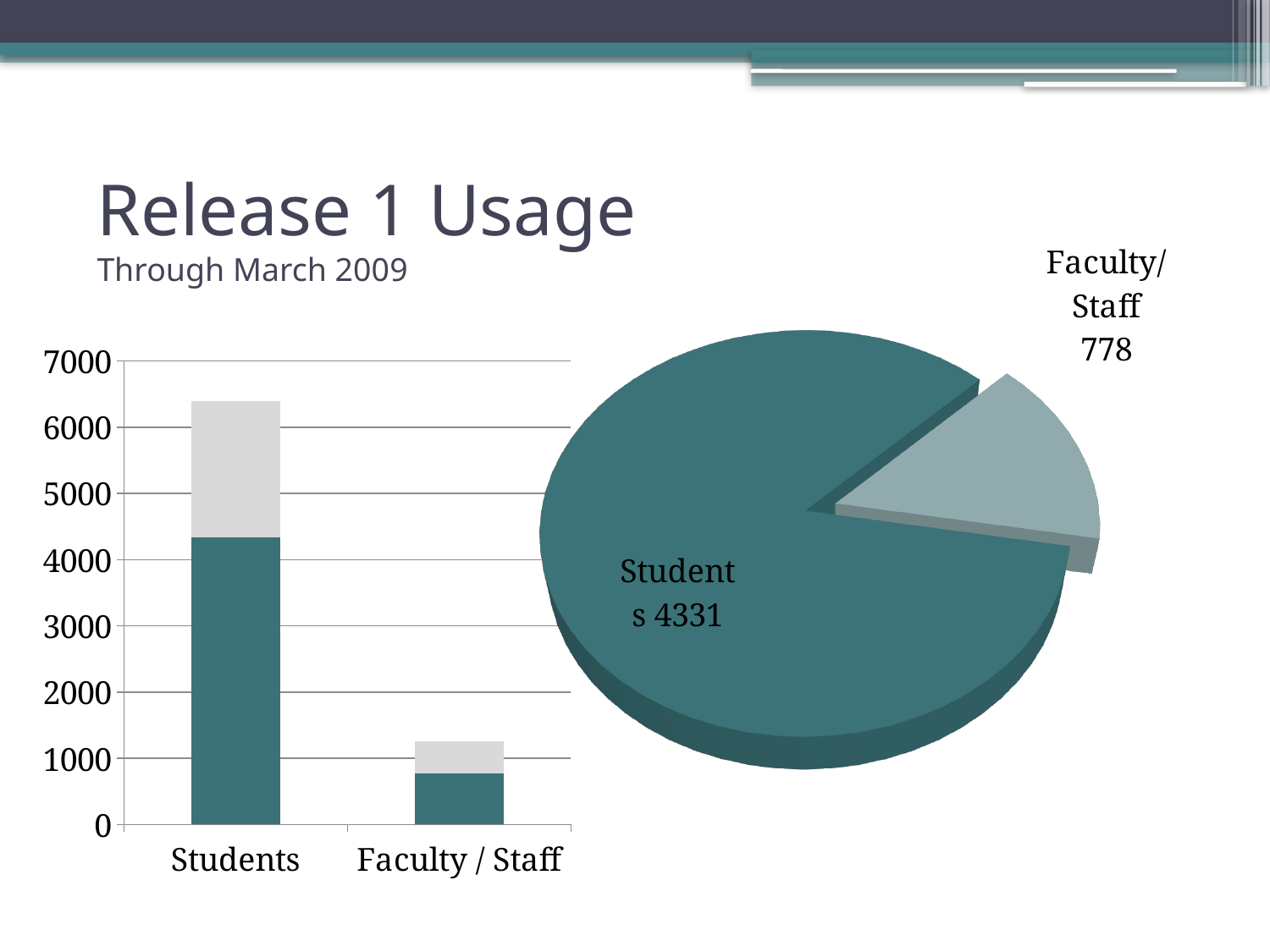
What kind of chart is on the left side of the slide? Bar chart In the pie chart on the right, what is the value for Students? 4331 In the pie chart on the right, which slice is the largest? Students In the pie chart on the right, what is the difference between the Students value and the Faculty/Staff value? 3553 In the pie chart on the right, what is the value for Faculty/Staff? 778 What kind of chart is on the right side of the slide? Pie chart In the bar chart on the left, is the total height of the Faculty / Staff bar greater or less than 2000? less In the bar chart on the left, is the total height of the Students bar greater or less than 6000? greater In the pie chart on the right, which slice is the smallest? Faculty/Staff In the bar chart on the left, how many categories are shown on the x axis? 2 In the bar chart on the left, which category has the taller bar, Students or Faculty / Staff? Students In the pie chart on the right, how many slices are there? 2